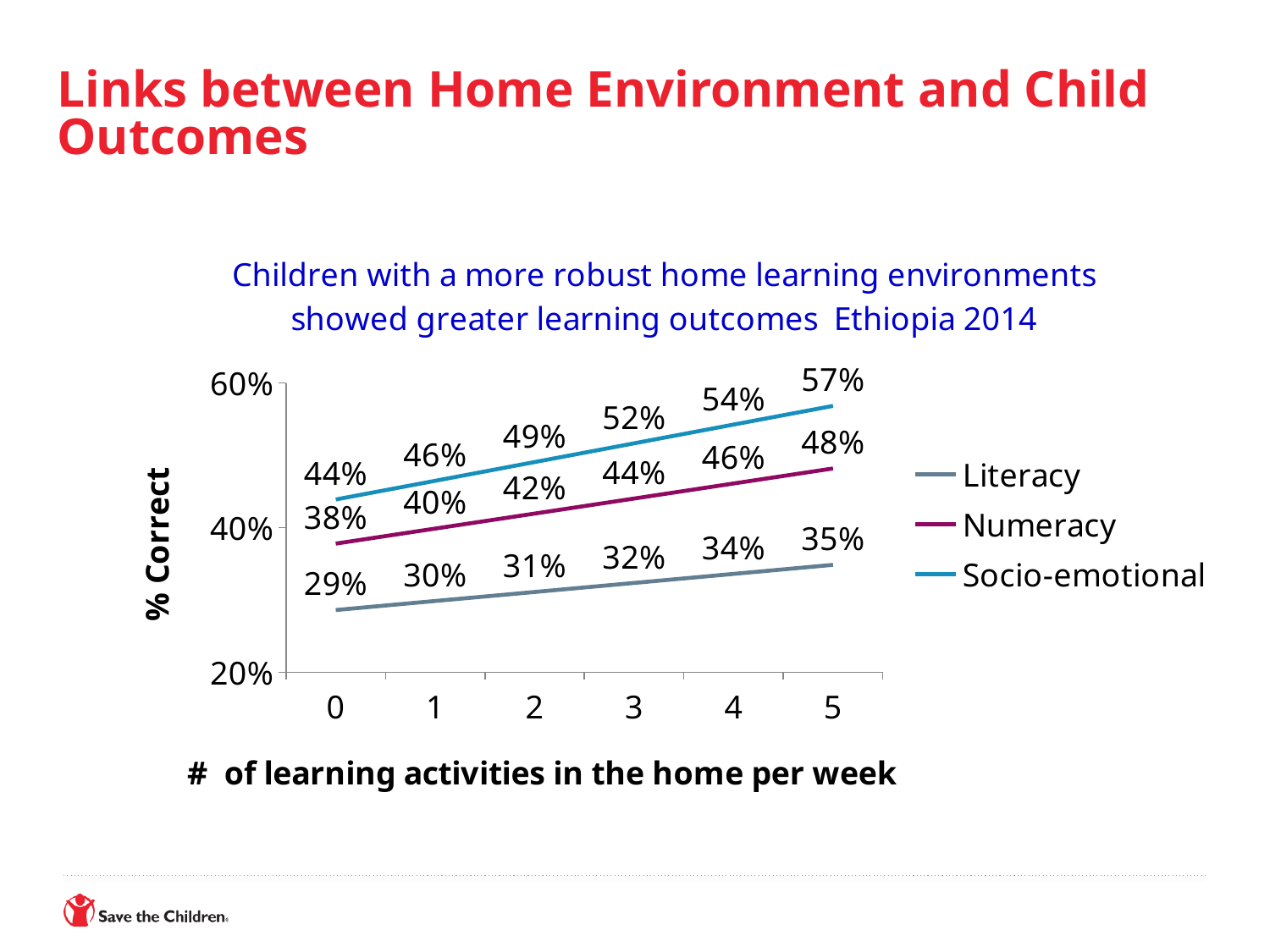
What is the Socio-emotional value at 5 learning activities per week? 57% Which is larger: the Numeracy value at 2 activities or the Literacy value at 5 activities? Numeracy at 2 activities Do the Numeracy values rise or fall as the number of learning activities increases? Rise How many series does the legend list? 3 What is the Literacy value at 0 learning activities per week? 29% What is the Numeracy value at 3 learning activities per week? 44% Which series has the highest value at 5 learning activities per week? Socio-emotional How many points are plotted along the x axis for each series? 6 What type of chart is shown on the slide? Line chart Which series has the lowest value at 0 learning activities per week? Literacy What is the difference between the Socio-emotional value and the Literacy value at 5 learning activities per week? 22% What is the label of the y axis? % Correct